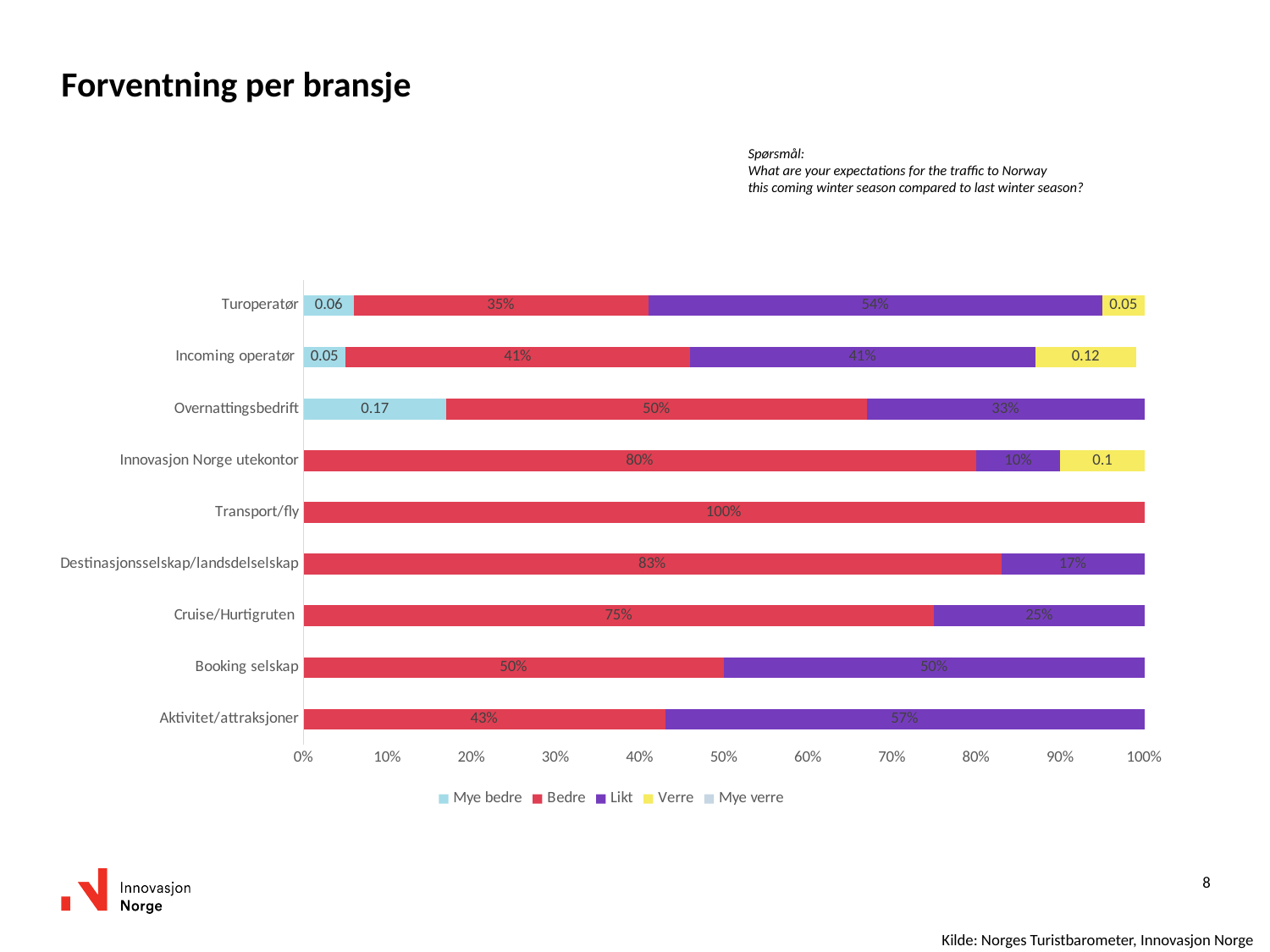
How many series does the legend list? 5 What is the 'Verre' value for Incoming operatør? 0.12 What kind of chart is shown on the slide? bar chart What is the 'Likt' value for Turoperatør? 54% Which has the larger 'Likt' value: Aktivitet/attraksjoner or Cruise/Hurtigruten? Aktivitet/attraksjoner Which category has the highest 'Bedre' value? Transport/fly How many categories (industries) are plotted on the chart? 9 Which category has the lowest 'Bedre' value? Turoperatør What is the 'Bedre' value for Transport/fly? 100% What is the 'Likt' value for Innovasjon Norge utekontor? 10% What is the 'Mye bedre' value for Overnattingsbedrift? 0.17 What is the difference between the 'Bedre' values for Destinasjonsselskap/landsdelselskap and Cruise/Hurtigruten? 8%